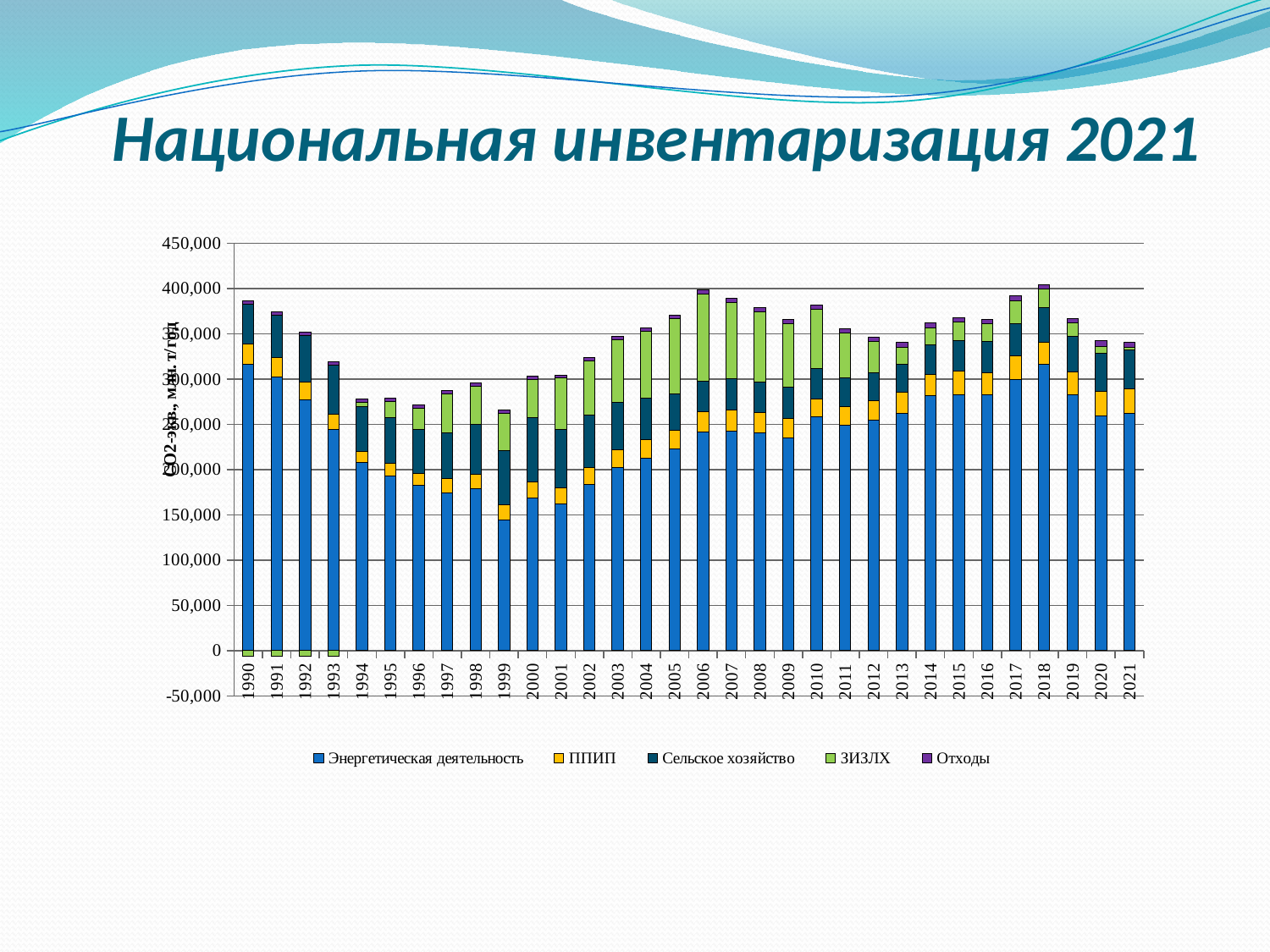
Is the total height of the stacked bar for 2017 greater or less than 350,000? greater In which year is the Энергетическая деятельность segment the lowest? 1999 How many years (categories) are shown on the x axis of the chart? 32 Is the value of Энергетическая деятельность for 1996 greater or less than 200,000? less Does the Энергетическая деятельность value rise or fall from 1990 to 1999? fall Is the total height of the stacked bar for 1994 greater or less than 300,000? less What is the title of the slide containing the chart? Национальная инвентаризация 2021 Which series is listed first in the chart legend? Энергетическая деятельность How many series does the chart legend list? 5 What kind of chart is shown on the slide? Stacked bar chart Which year has the larger Энергетическая деятельность value, 1990 or 1999? 1990